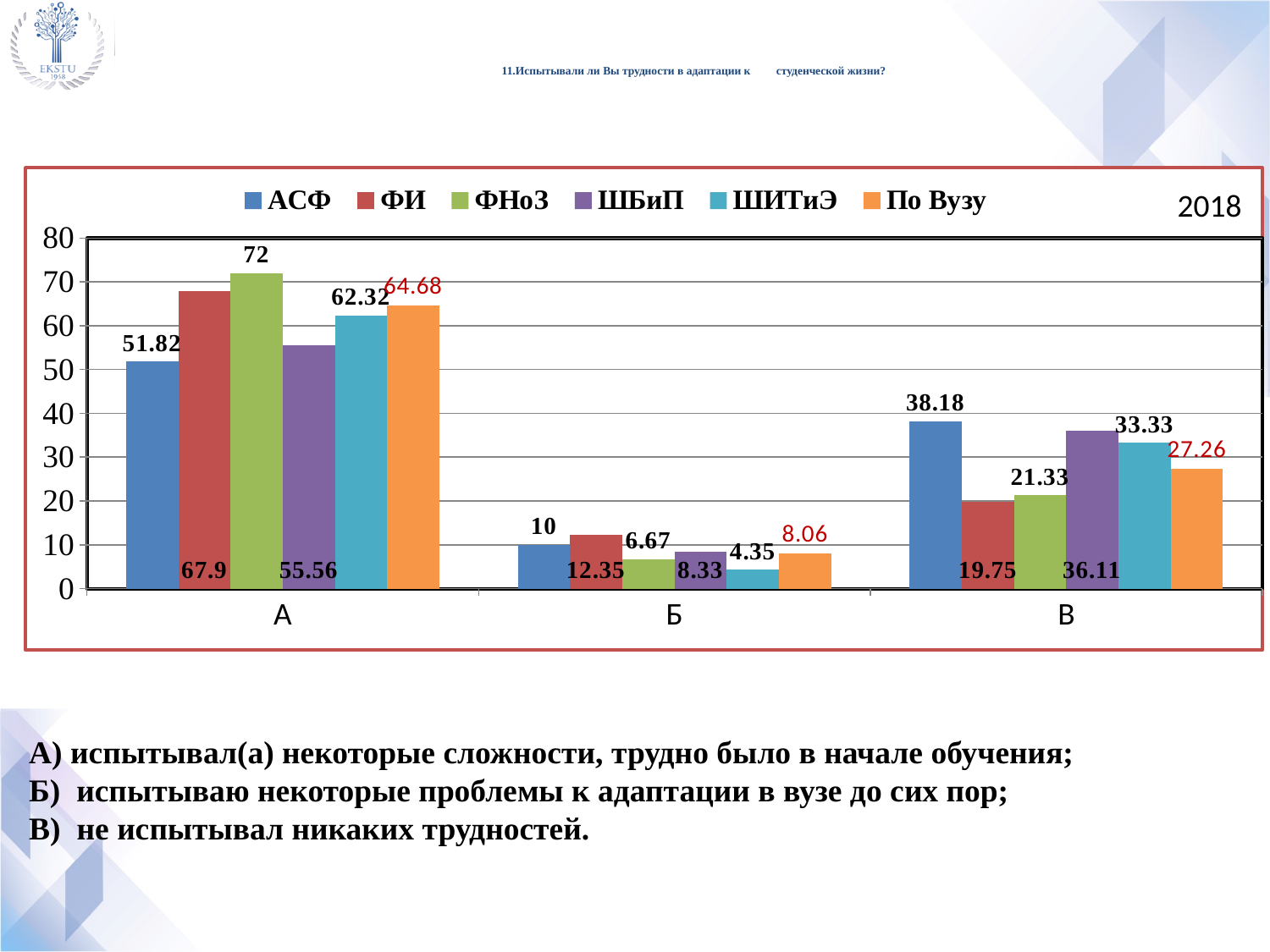
What is the difference between the АСФ value and the ФИ value in category В? 18.43 What value is shown for ШИТиЭ in category Б? 4.35 Which is larger in category А: the value for ШБиП or the value for ШИТиЭ? ШИТиЭ How many series does the legend list? 6 What value is shown for АСФ in category В? 38.18 What kind of chart is shown on the slide? bar chart What year is indicated in the top right corner of the chart? 2018 What value is shown for По Вузу in category В? 27.26 Which series has the lowest value in category Б? ШИТиЭ Which series has the highest value in category А? ФНоЗ Is the value for ФИ in category А greater or less than 60? greater What value is shown for ФНоЗ in category А? 72